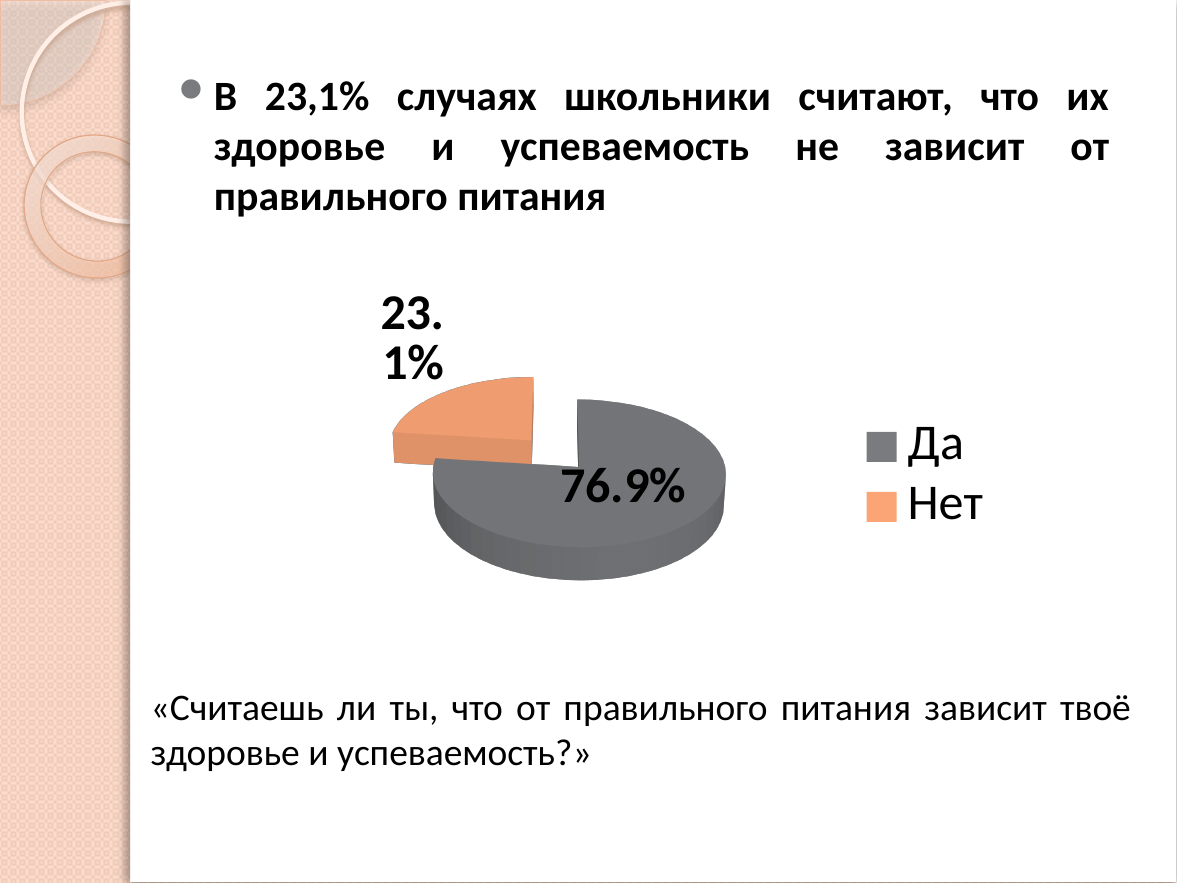
What are the two legend entries of the pie chart? Да, Нет What kind of chart is shown on the slide? pie chart Which is larger, the share for "Да" or the share for "Нет"? Да How many entries does the legend list? 2 Which slice of the pie is the largest? Да What percentage of the pie corresponds to "Нет"? 23.1% Which slice of the pie is the smallest? Нет What percentage of the pie corresponds to "Да"? 76.9% By how many percentage points does the "Да" share exceed the "Нет" share? 53.8 What colour is the "Нет" slice in the pie chart? orange How many slices does the pie chart have? 2 What share of the pie does the "Нет" slice take? 23.1%